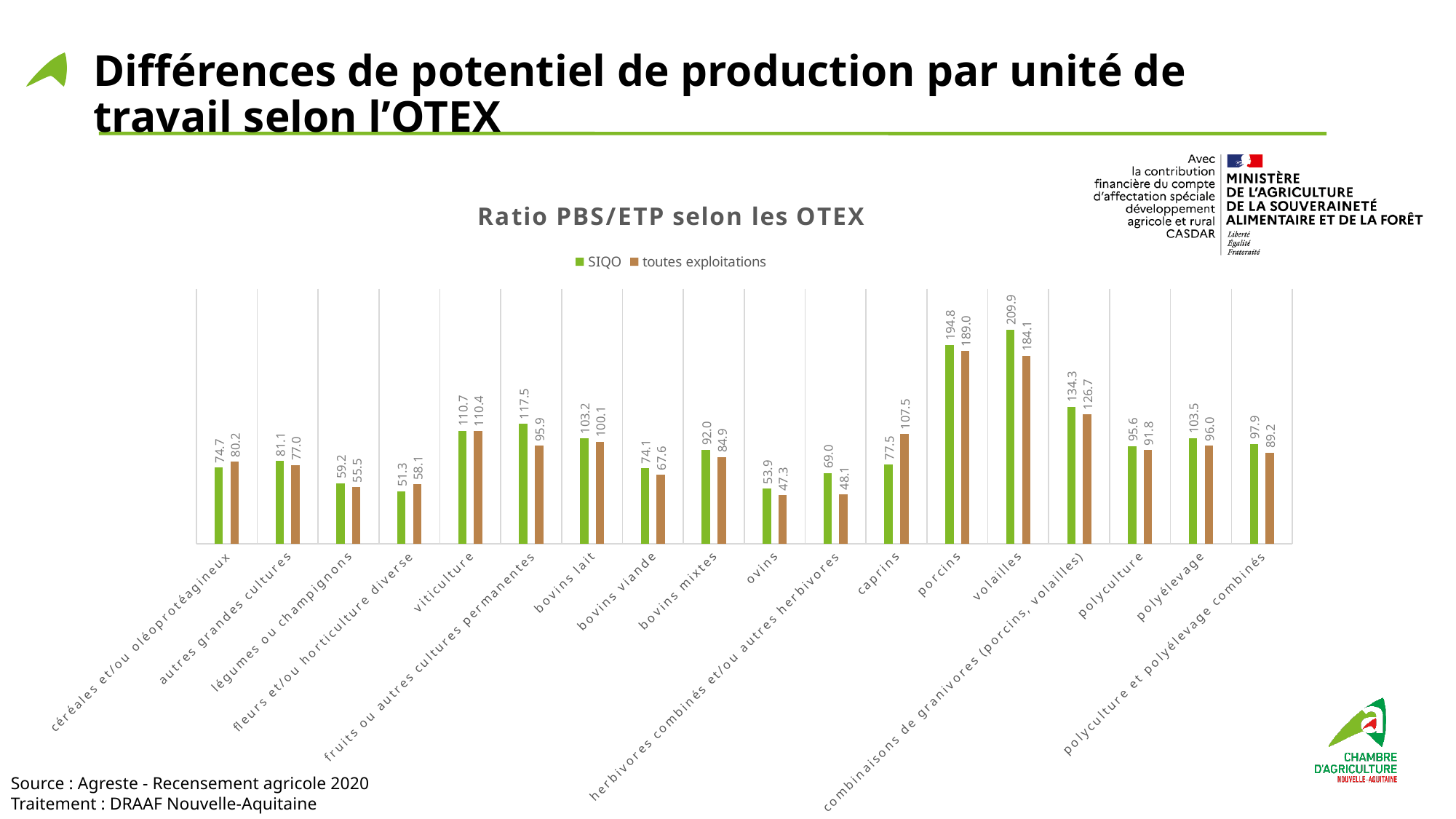
What is the SIQO value for volailles? 209.9 Which category has the lowest 'toutes exploitations' value? ovins For fruits ou autres cultures permanentes, which is larger: the SIQO value or the 'toutes exploitations' value? SIQO What is the difference between the 'toutes exploitations' and SIQO values for caprins? 30.0 What is the title of the chart? Ratio PBS/ETP selon les OTEX What is the SIQO value for viticulture? 110.7 How many OTEX categories are plotted on the x axis? 18 How many series does the legend list? 2 What is the 'toutes exploitations' value for caprins? 107.5 What type of chart is shown on the slide? bar chart Which category has the highest SIQO value? volailles Which category has the highest 'toutes exploitations' value? porcins